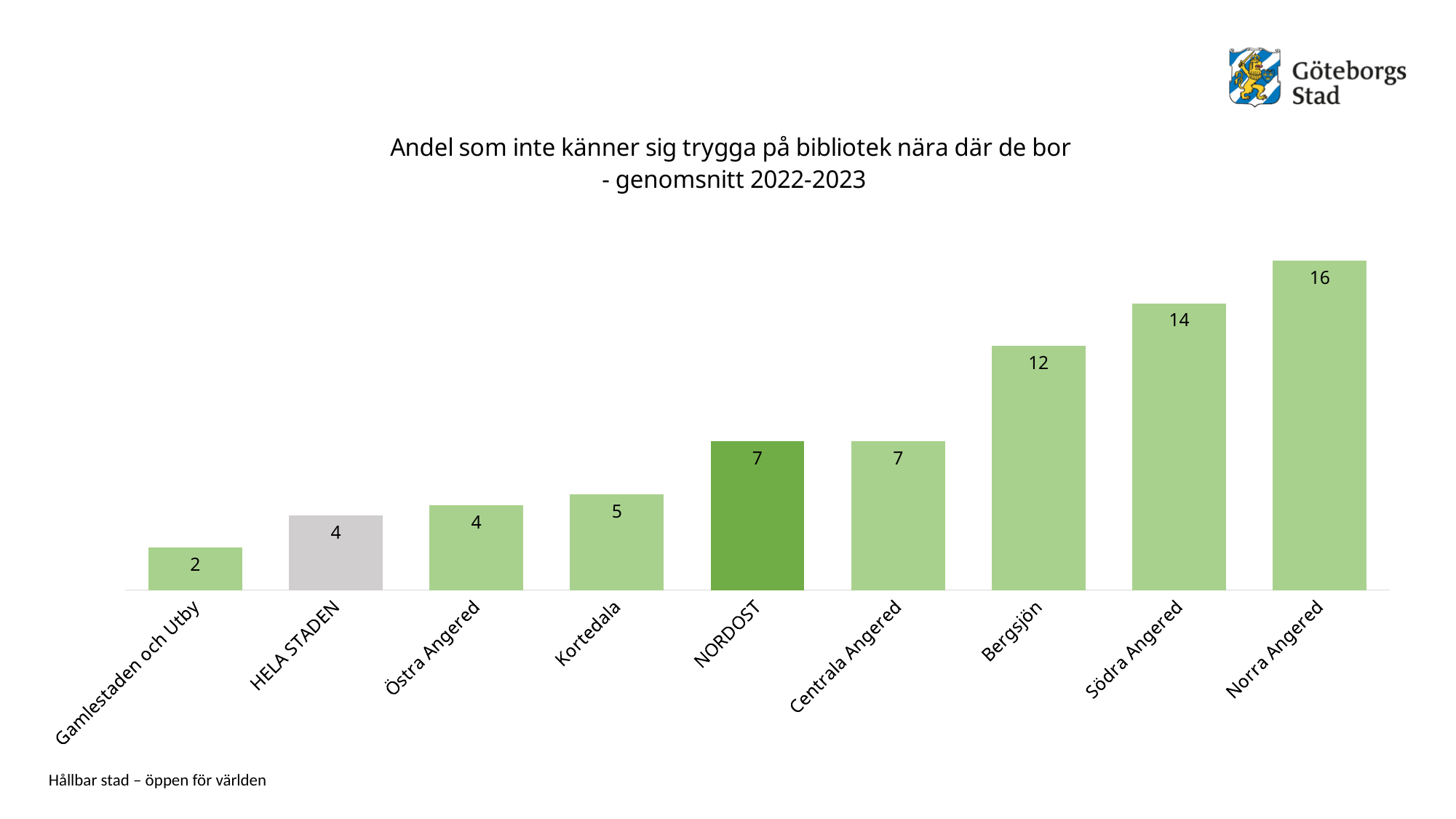
What is the value for Bergsjön? 12 What is the value for Kortedala? 5 Which category has the highest value? Norra Angered How many categories are shown in the chart? 9 What is the value for Norra Angered? 16 What is the value for HELA STADEN? 4 Which category has the lowest value? Gamlestaden och Utby Which is larger, the value for Södra Angered or the value for Bergsjön? Södra Angered What kind of chart is shown on the slide? Bar chart What is the difference between the values for Norra Angered and Södra Angered? 2 Which bar is shown in grey rather than green? HELA STADEN What is the difference between the values for Bergsjön and NORDOST? 5